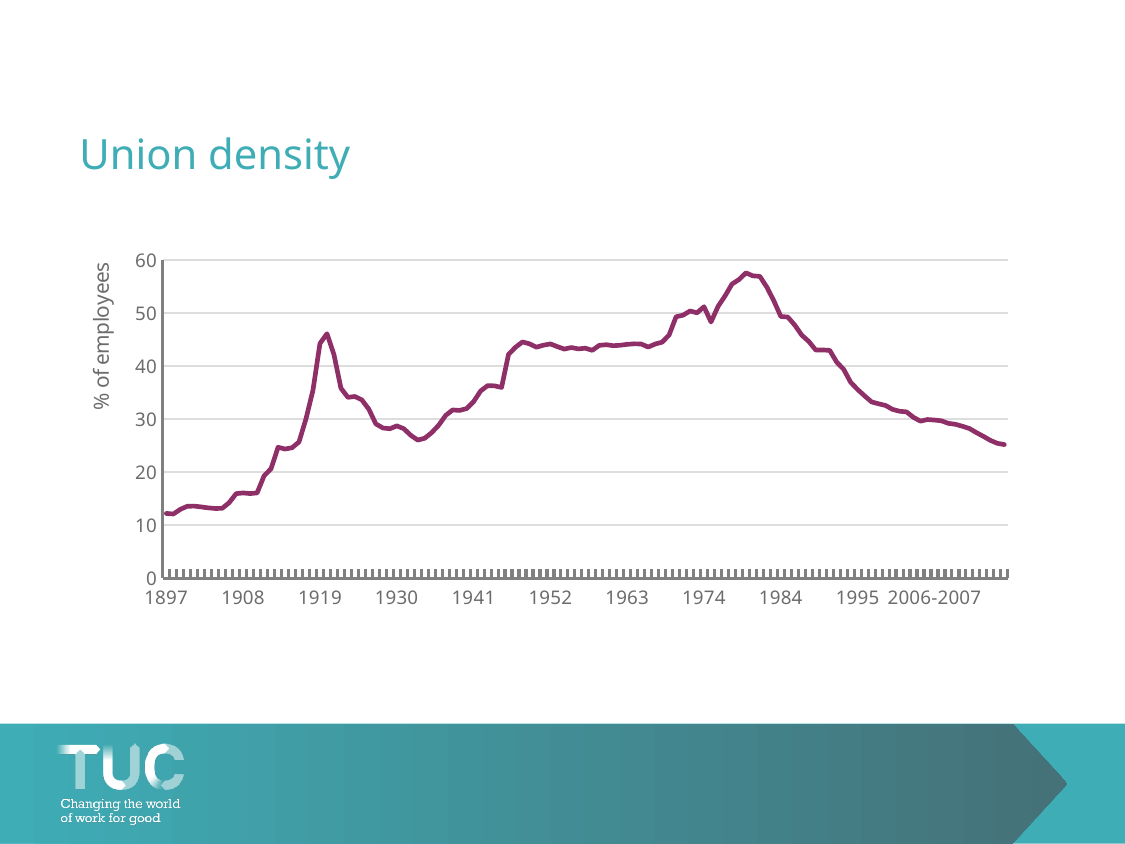
Does the line rise or fall between 1984 and 2006-2007? fall Is the highest point of the line greater or less than 50? greater Is the value for 1919 greater or less than 40? greater Is the value for 1930 greater or less than 30? less Between which two labelled years on the x axis does the line reach its highest point? 1974 and 1984 How many lines (series) are plotted on the chart? 1 What kind of chart is shown on the slide? line chart What is the label on the vertical axis of the chart? % of employees Which is larger, the value for 1919 or the value for 1930? 1919 What is the title of the chart? Union density